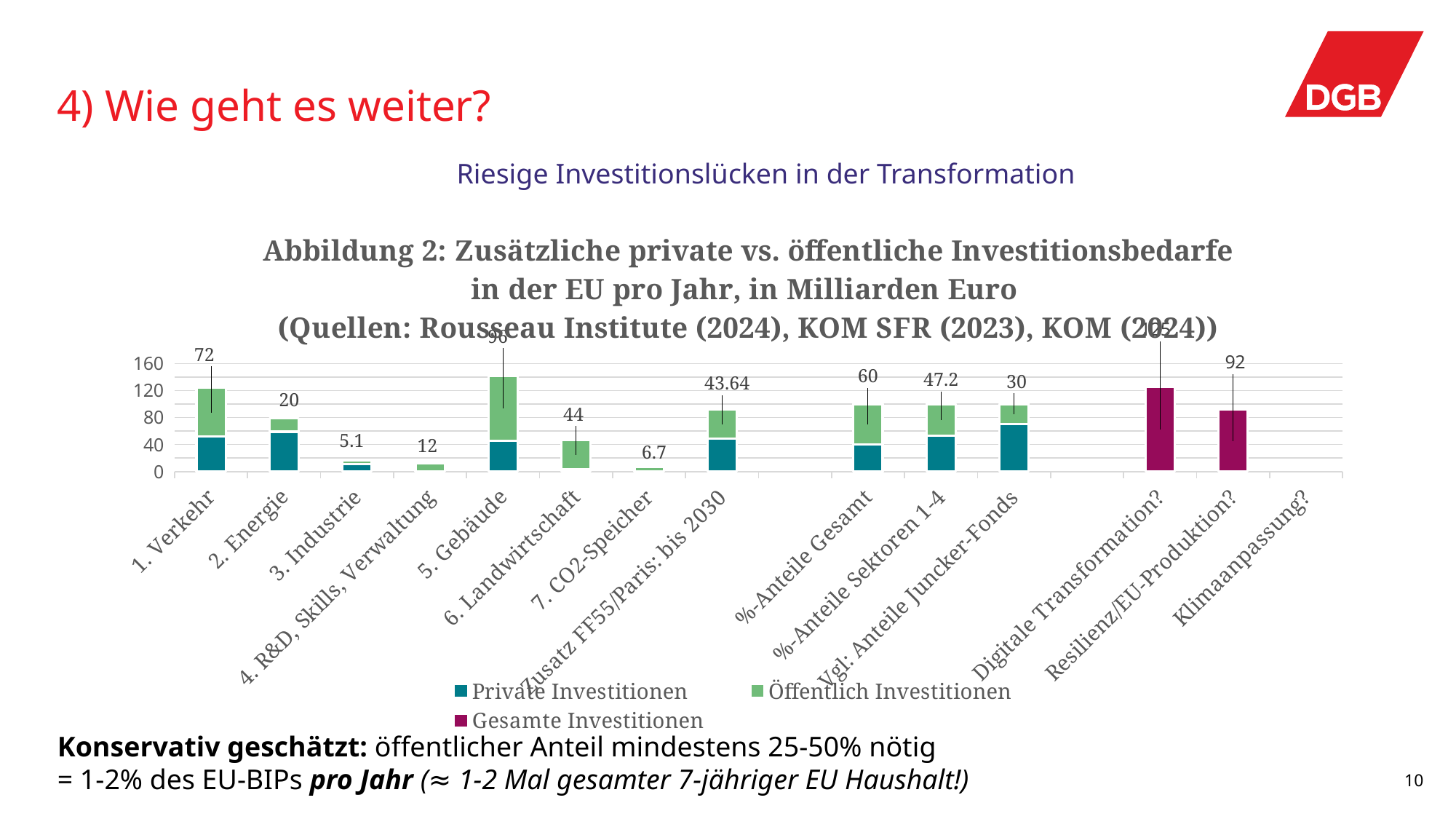
Is the bar for Resilienz/EU-Produktion? greater or less than 120? less What data label is printed above the bar for Resilienz/EU-Produktion? 92 What data label is printed above the bar for 7. CO2-Speicher? 6.7 Which stacked bar is taller, 1. Verkehr or 2. Energie? 1. Verkehr How many categories are shown on the x axis of the chart? 14 Which category has the tallest stacked bar in the chart? 5. Gebäude What kind of chart is shown on the slide? bar chart What data label is printed above the bar for Zusatz FF55/Paris: bis 2030? 43.64 How many series does the chart legend list? 3 Which legend entry is shown in purple/magenta? Gesamte Investitionen What data label is printed above the bar for 2. Energie? 20 Is the total stacked bar for 5. Gebäude greater or less than 120? greater